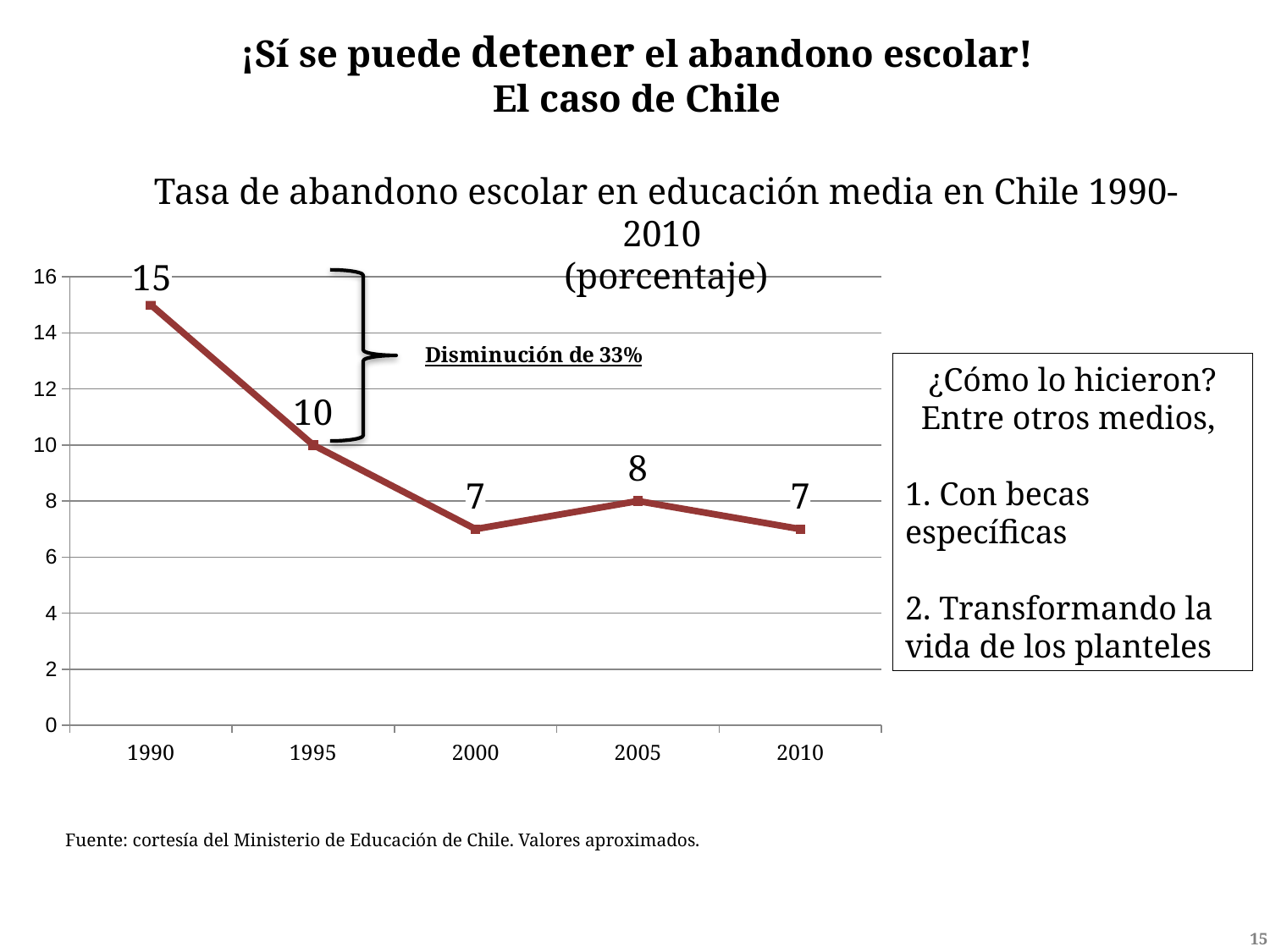
What is the value for 1995? 10 Which is larger, the value for 2005 or the value for 2000? 2005 What kind of chart is shown? line chart Which year has the highest value? 1990 Do the values generally rise or fall from 1990 to 2010? fall Is the value for 1995 greater or less than 12? less What percentage decrease does the annotation on the chart state between 1990 and 1995? 33% What is the difference between the values for 1990 and 1995? 5 What is the value for 1990? 15 What is the value for 2005? 8 What is the difference between the values for 1990 and 2010? 8 How many years are plotted on the chart? 5